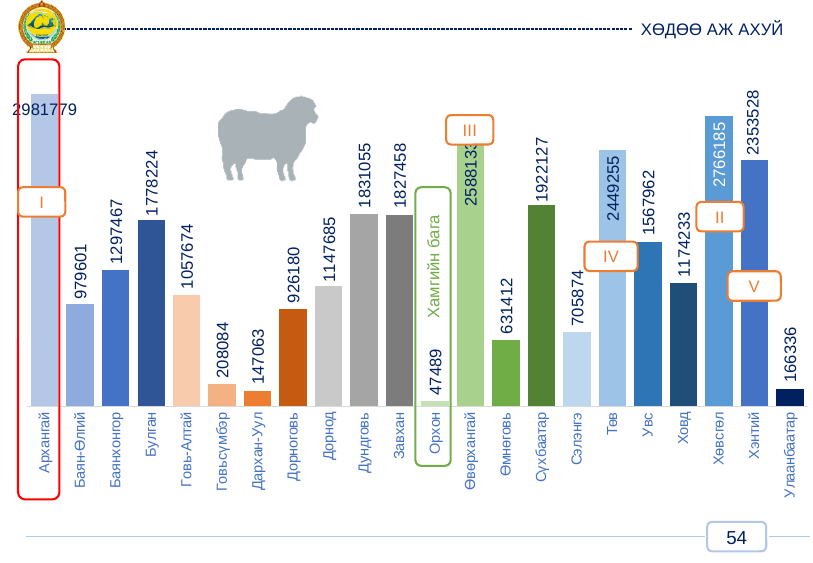
What type of chart is shown on the slide? bar chart What is the difference between the values for Архангай and Хөвсгөл? 215594 Which province has the lowest value in the chart? Орхон How many provinces (categories) are shown in the chart? 22 Which province is marked with the callout "II" in the chart? Хөвсгөл What is the value shown for Архангай? 2981779 Which has a larger value, Төв or Хэнтий? Төв What is the value shown for Сүхбаатар? 1922127 What is the value shown for Хөвсгөл? 2766185 What is the value shown for Орхон? 47489 Which province has the highest value in the chart? Архангай What is the difference between the values for Булган and Баянхонгор? 480757